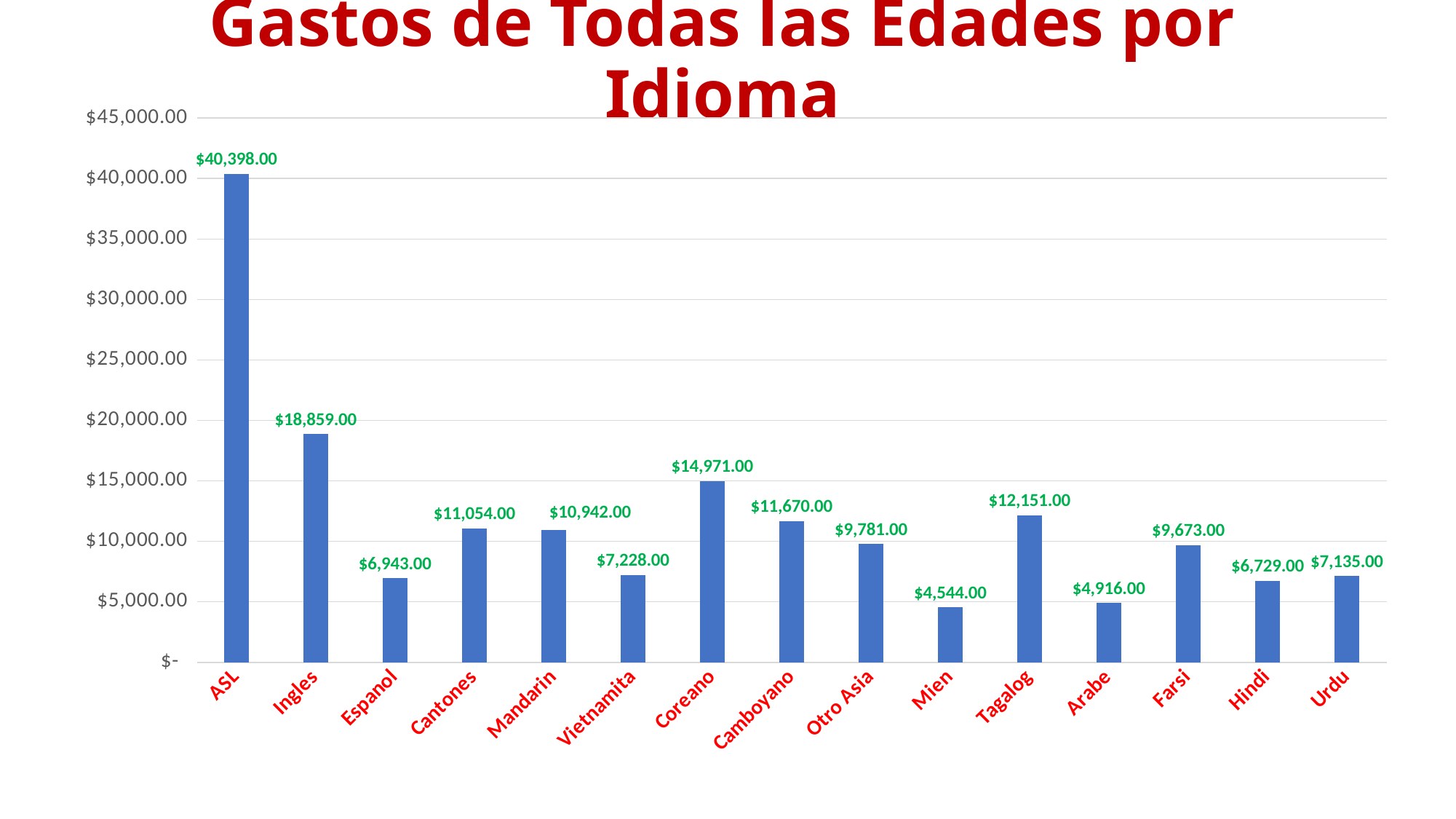
What kind of chart is shown on the slide? Bar chart What is the value for Tagalog? $12,151.00 What is the difference between the values for ASL and Ingles? $21,539.00 What is the value for Coreano? $14,971.00 Which language has the highest expenditure? ASL How many languages are shown on the x axis? 15 Is the value for Ingles greater or less than $15,000.00? greater What is the value for Hindi? $6,729.00 Which language has the lowest expenditure? Mien What is the difference between the values for Coreano and Tagalog? $2,820.00 Which is larger, the value for Camboyano or the value for Otro Asia? Camboyano What is the value for ASL? $40,398.00